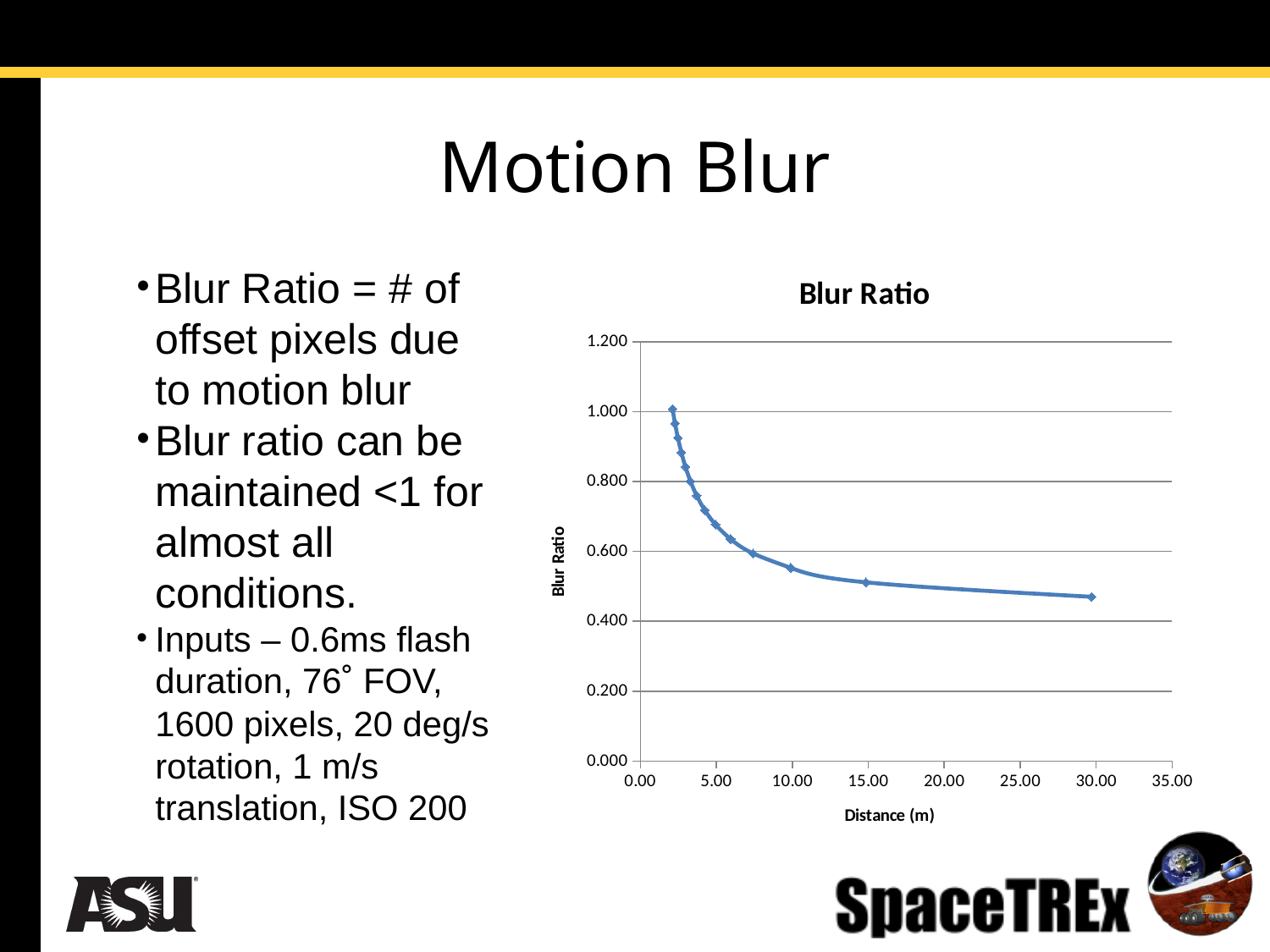
What is the label of the x axis of the chart? Distance (m) Is the blur ratio at a distance of about 15 m greater or less than 0.600? less Which has the larger blur ratio: the point at about 10 m or the point at about 30 m? the point at about 10 m Is the blur ratio at a distance of about 5 m greater or less than 0.600? greater Does the blur ratio rise or fall as distance increases along the x axis? fall What type of chart is shown on the slide? line chart Is the blur ratio at a distance of about 5 m greater or less than 0.800? less At which end of the distance range is the blur ratio highest: the shortest distance or the longest distance? the shortest distance What is the title of the chart? Blur Ratio